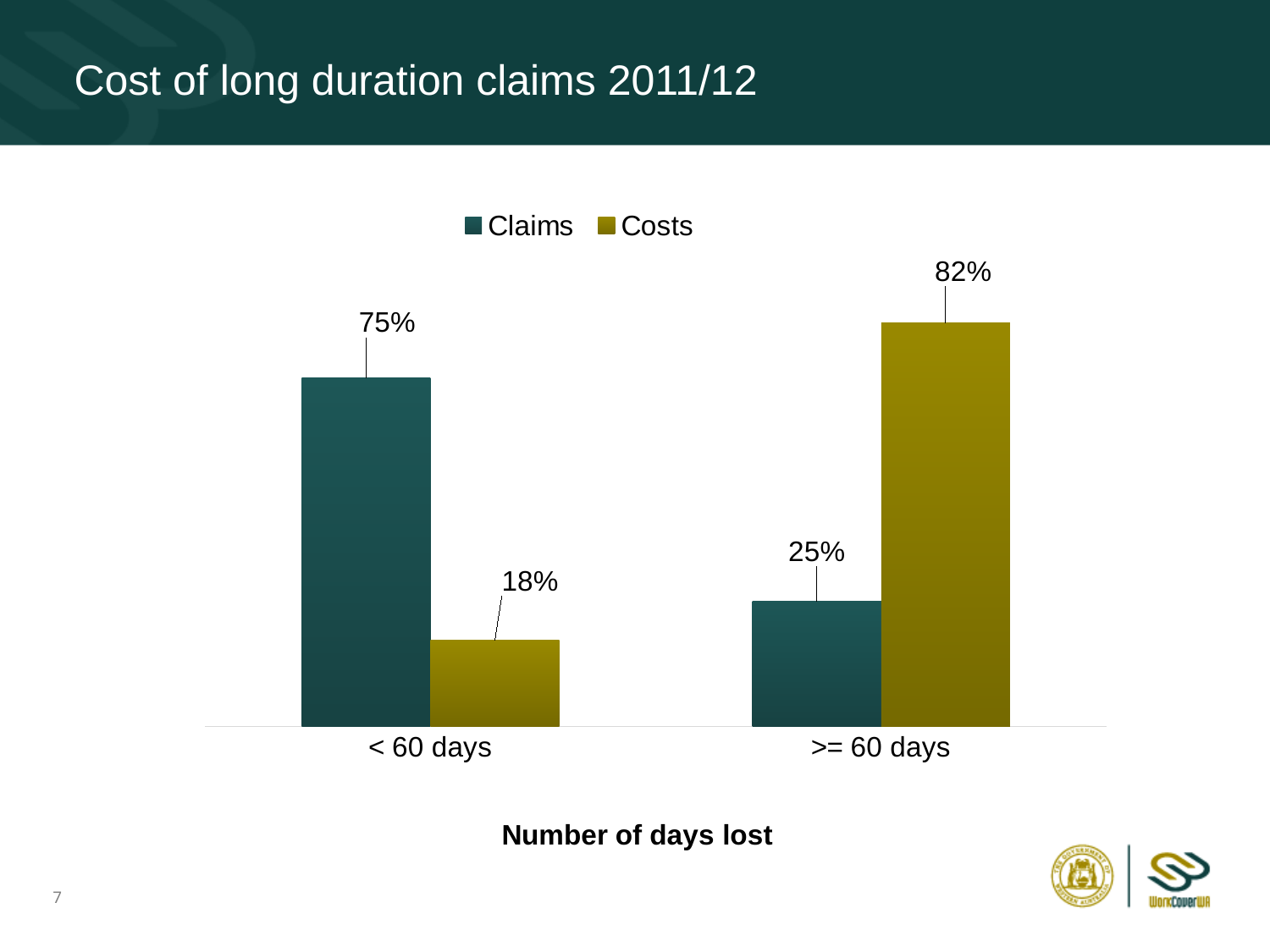
What is the Claims value for < 60 days? 75% How many categories are shown on the x axis? 2 What is the difference between the Claims and Costs values for < 60 days? 57% What is the Costs value for >= 60 days? 82% Which category has the lowest Claims value? >= 60 days What kind of chart is shown on the slide? Bar chart How many series does the legend list? 2 Which category has the highest Costs value? >= 60 days What is the difference between the Costs values for >= 60 days and < 60 days? 64% Which is larger for >= 60 days, Claims or Costs? Costs What is the Costs value for < 60 days? 18% What is the Claims value for >= 60 days? 25%